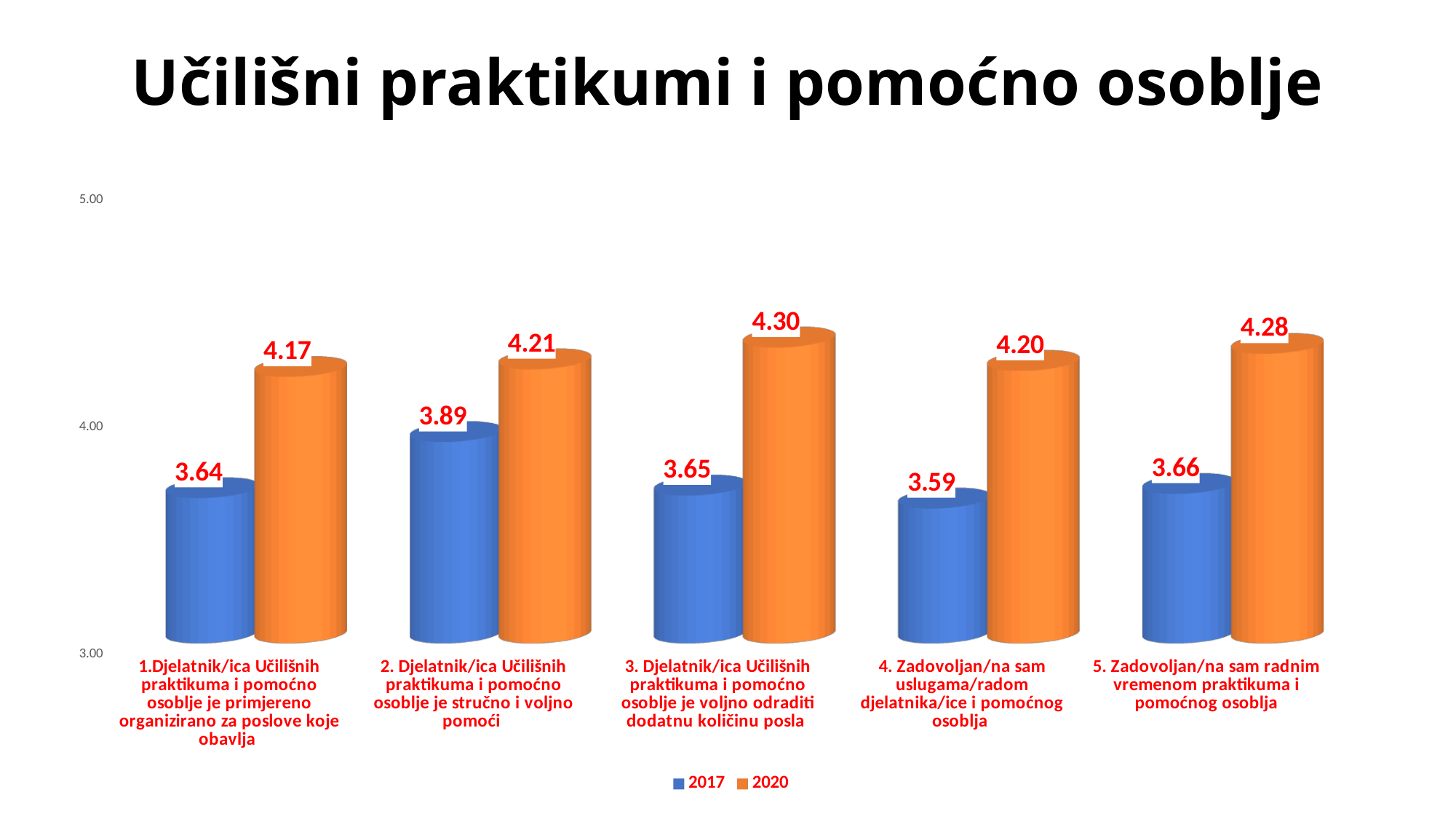
How many statements (categories) are shown on the chart? 5 Is the 2017 value for statement 3 greater or less than 4.00? less Which statement has the highest 2020 value? 3. Djelatnik/ica Učilišnih praktikuma i pomoćno osoblje je voljno odraditi dodatnu količinu posla What is the 2017 value for statement 4 (Zadovoljan/na sam uslugama/radom djelatnika/ice i pomoćnog osoblja)? 3.59 What is the difference between the 2020 and 2017 values for statement 5 (Zadovoljan/na sam radnim vremenom praktikuma i pomoćnog osoblja)? 0.62 Which statement has the highest 2017 value? 2. Djelatnik/ica Učilišnih praktikuma i pomoćno osoblje je stručno i voljno pomoći Which is larger for statement 2: the 2017 value or the 2020 value? 2020 What kind of chart is shown on the slide? Bar chart How many series does the legend list? 2 Which statement has the lowest 2017 value? 4. Zadovoljan/na sam uslugama/radom djelatnika/ice i pomoćnog osoblja What is the 2017 value for statement 1 (Djelatnik/ica Učilišnih praktikuma i pomoćno osoblje je primjereno organizirano za poslove koje obavlja)? 3.64 What is the 2020 value for statement 3 (Djelatnik/ica Učilišnih praktikuma i pomoćno osoblje je voljno odraditi dodatnu količinu posla)? 4.30